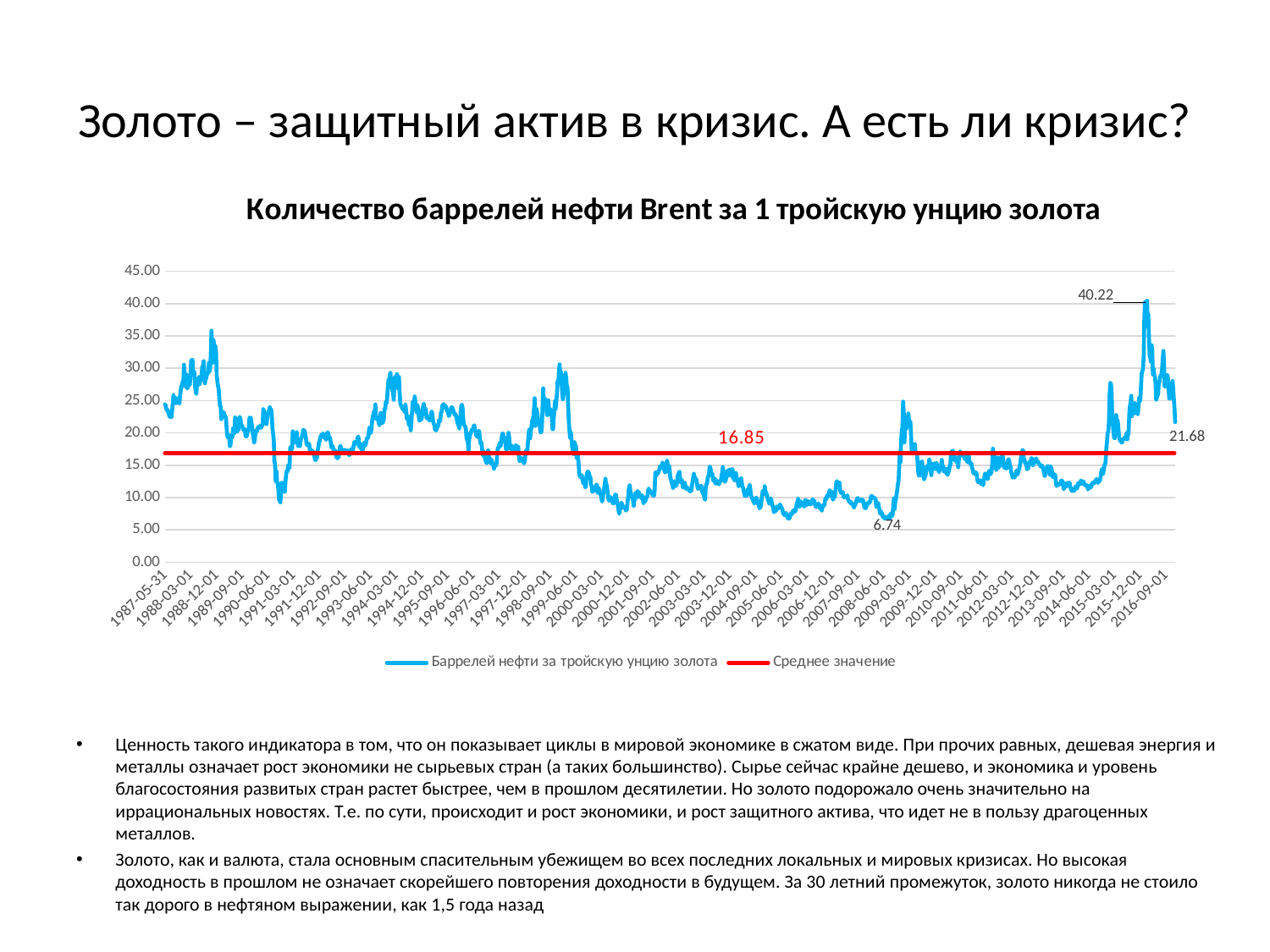
What is the difference between the highest labelled value (40.22) and the lowest labelled value (6.74)? 33.48 What is the highest labelled value of the series 'Баррелей нефти за тройскую унцию золота'? 40.22 What value is shown for the series 'Среднее значение'? 16.85 What is the lowest labelled value of the series 'Баррелей нефти за тройскую унцию золота'? 6.74 What kind of chart is shown on the slide? line chart By how much does the last labelled value (21.68) exceed the average value (16.85)? 4.83 Which is larger: the last labelled value of the blue line or the average value shown by the red line? the last labelled value (21.68) Is the value of the blue line at the start of the chart (1987-05-31) greater or less than 20.00? greater What colour is the line for 'Среднее значение'? red What is the title of the chart? Количество баррелей нефти Brent за 1 тройскую унцию золота What is the last labelled value of the blue line at the right end of the chart? 21.68 How many series does the chart legend list? 2